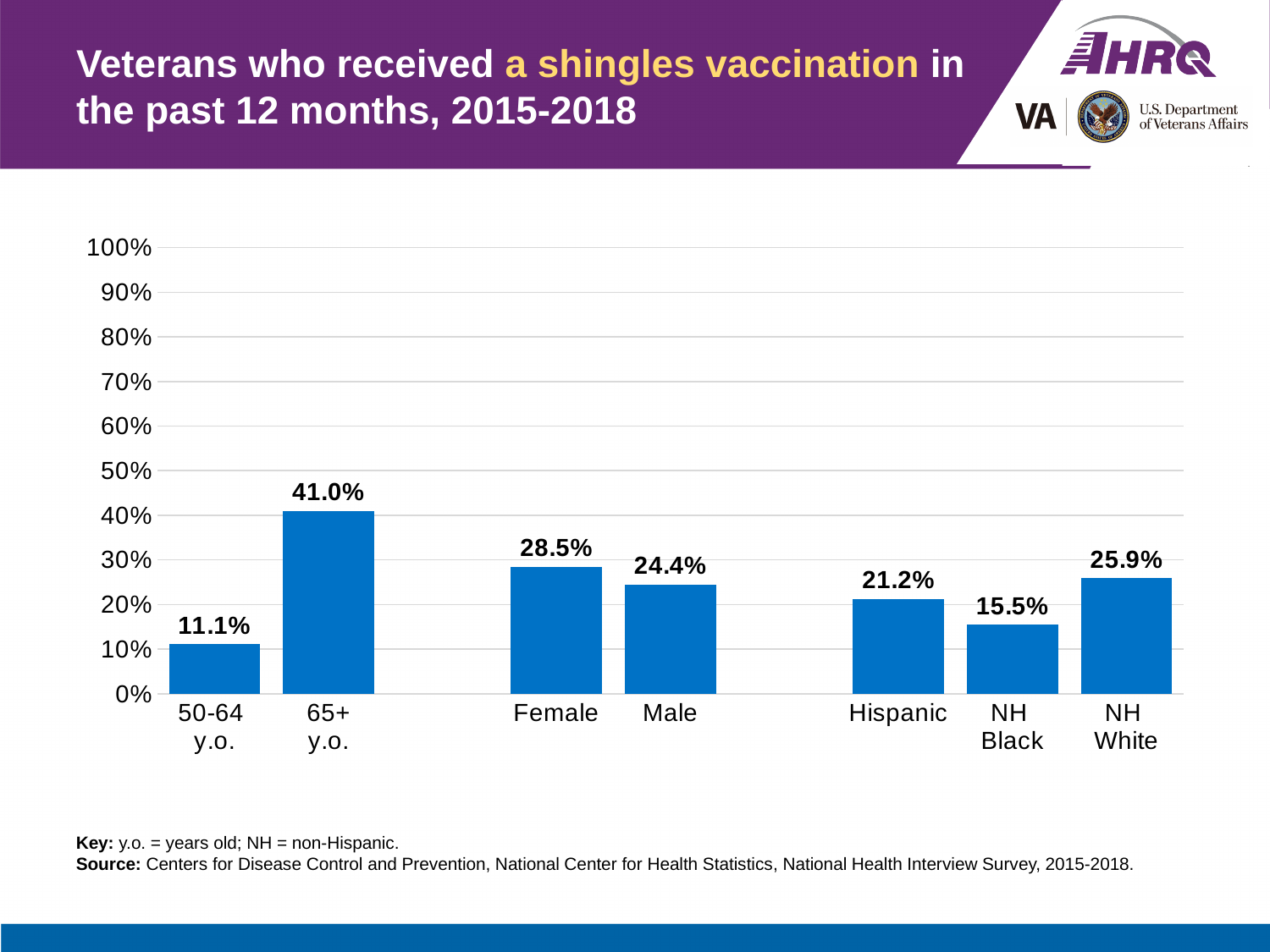
What percentage of veterans aged 65+ y.o. received a shingles vaccination in the past 12 months? 41.0% Which is larger, the value for Hispanic veterans or the value for NH White veterans? NH White What kind of chart is shown on the slide? Bar chart Is the value for 65+ y.o. veterans greater or less than 40%? greater What is the difference in percentage points between NH White and NH Black veterans? 10.4 What is the value shown for Female veterans? 28.5% Which category has the lowest percentage of veterans who received a shingles vaccination? 50-64 y.o. What is the difference in percentage points between Female and Male veterans? 4.1 What is the value shown for NH Black veterans? 15.5% What is the highest value shown on the y axis of the chart? 100% How many categories are shown on the x axis of the chart? 7 Which category has the highest percentage of veterans who received a shingles vaccination? 65+ y.o.